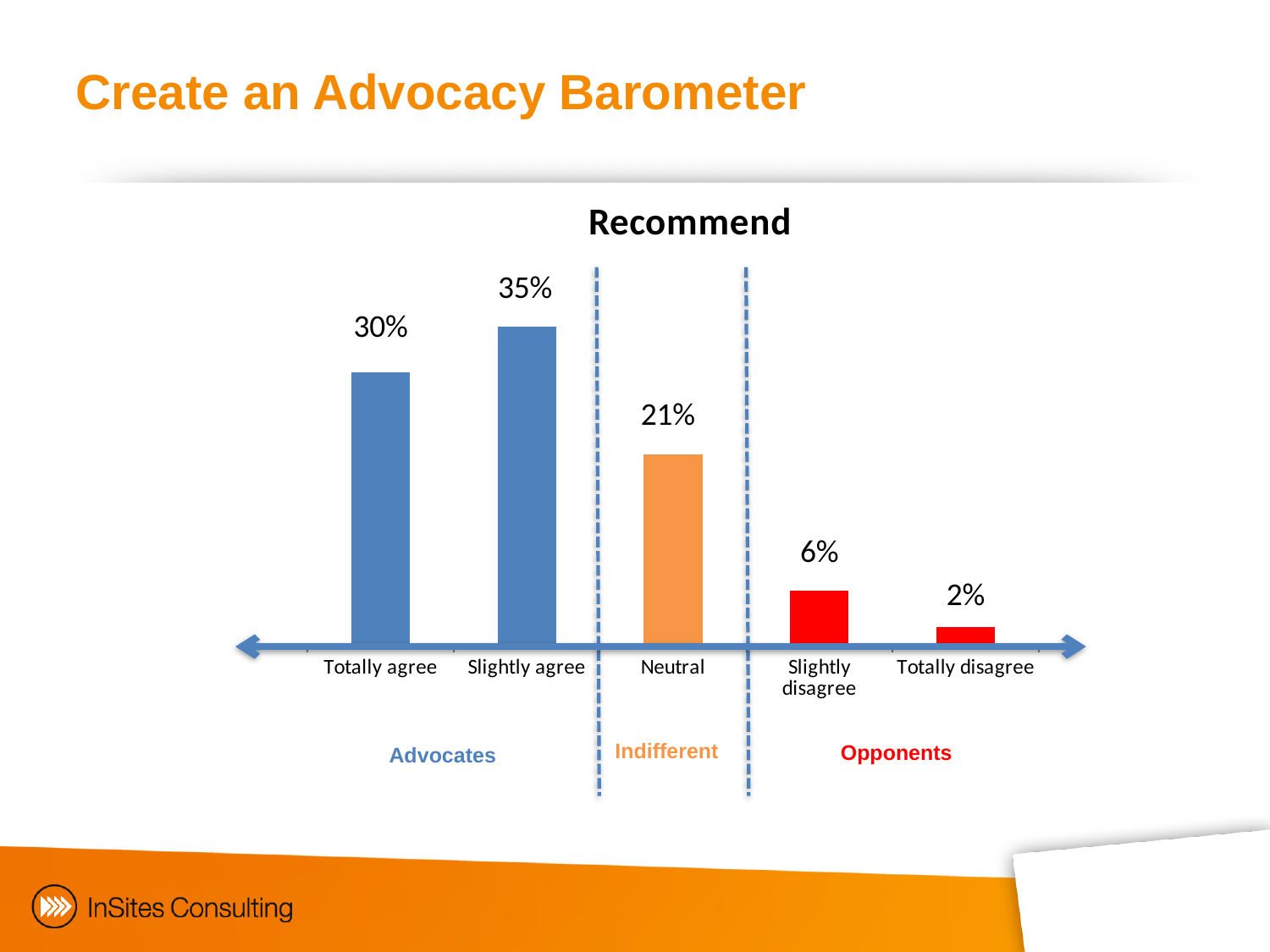
What colour are the bars in the Opponents group? Red Which is larger, Totally agree or Neutral? Totally agree How many categories are shown on the x axis? 5 What is the difference between Neutral and Slightly disagree? 15% What is the difference between Slightly agree and Totally agree? 5% What is the title of the chart? Recommend What is the value for Totally disagree? 2% What kind of chart is this? Bar chart Which category has the lowest value? Totally disagree Which category has the highest value? Slightly agree What is the value for Neutral? 21% What is the value for Slightly agree? 35%